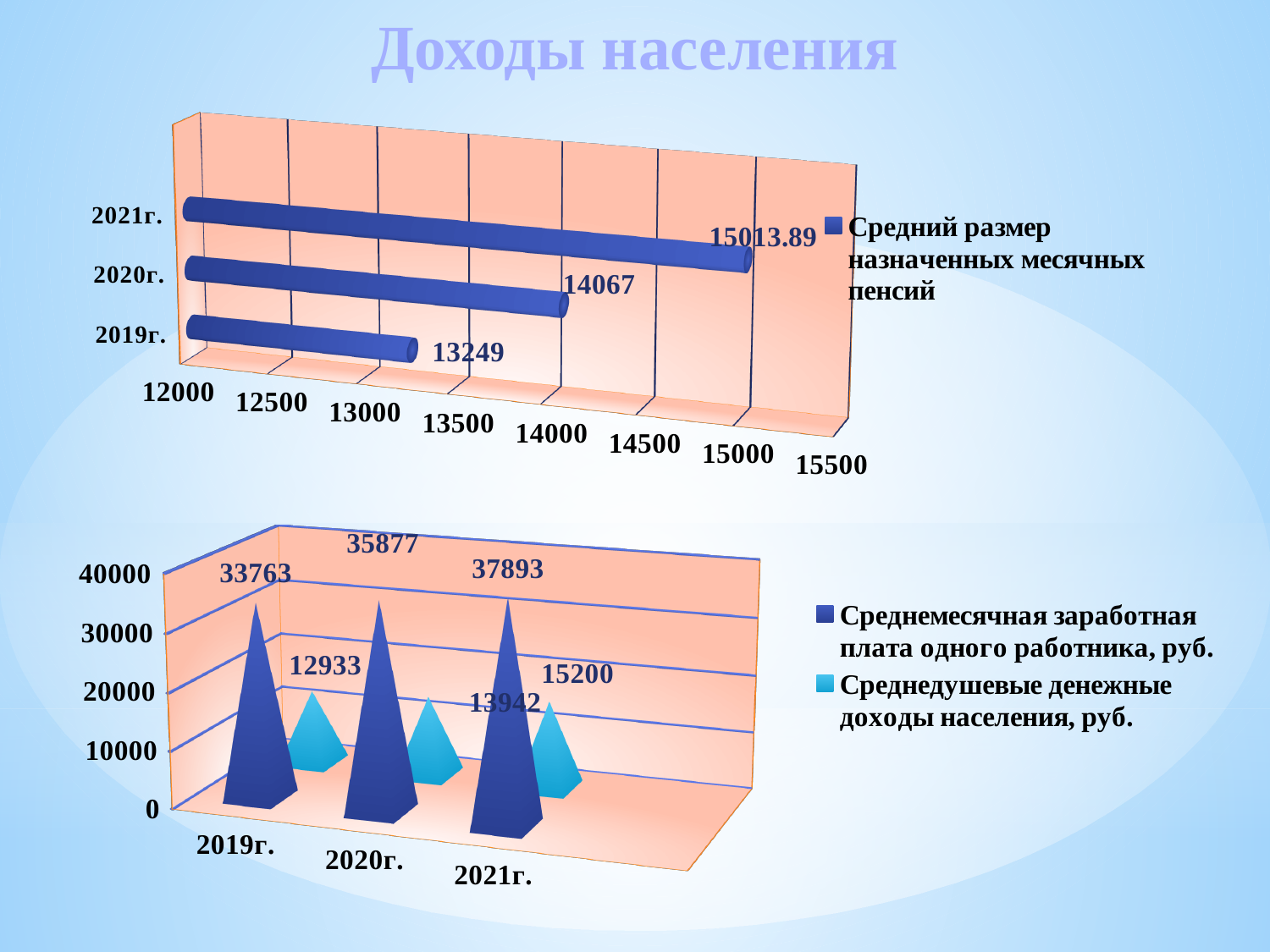
In the top chart, what is the average assigned monthly pension for 2021г.? 15013.89 How many series does the legend of the bottom chart list? 2 In the bottom chart, what is the per capita money income (Среднедушевые денежные доходы населения) in 2021г.? 15200 In the bottom chart, what is the difference between the average monthly wage and the per capita income in 2019г.? 20830 In the bottom chart, is the per capita income for 2020г. greater or less than 20000? less In the top chart, what is the difference between the 2020г. and 2019г. values? 818 In the bottom chart, which year has the highest average monthly wage? 2021г. In the top chart, do the values rise or fall from 2019г. to 2021г.? rise In the top chart, which year has the lowest average pension? 2019г. In the top chart, what is the value for 2019г.? 13249 What kind of chart is the top chart? bar chart In the bottom chart, what is the average monthly wage of one worker (Среднемесячная заработная плата одного работника) in 2020г.? 35877